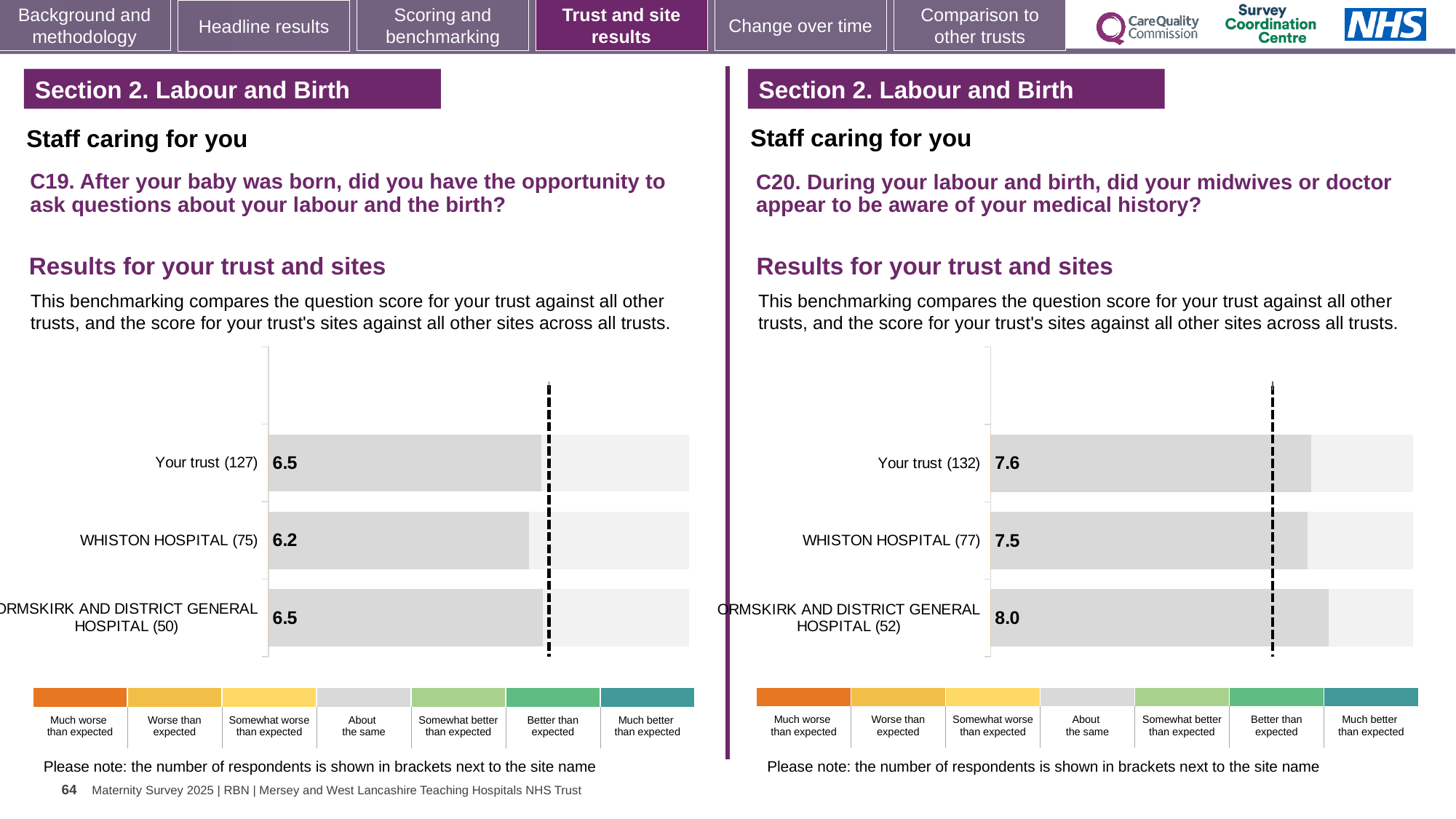
In the C20 chart on the right, what is the score for ORMSKIRK AND DISTRICT GENERAL HOSPITAL? 8.0 In the C20 chart on the right, which has the larger score, Your trust or ORMSKIRK AND DISTRICT GENERAL HOSPITAL? ORMSKIRK AND DISTRICT GENERAL HOSPITAL In the C19 chart on the left, what is the score for WHISTON HOSPITAL? 6.2 In the C19 chart on the left, which site or trust has the lowest score? WHISTON HOSPITAL In the C20 chart on the right, what is the score for Your trust? 7.6 How many bars are shown in the C19 chart on the left? 3 In the C20 chart on the right, which site or trust has the highest score? ORMSKIRK AND DISTRICT GENERAL HOSPITAL In the C20 chart on the right, what is the difference between the scores for ORMSKIRK AND DISTRICT GENERAL HOSPITAL and WHISTON HOSPITAL? 0.5 In the C19 chart on the left, how many respondents are shown in brackets for WHISTON HOSPITAL? 75 What type of chart is used in the C20 chart on the right? Bar chart In the C19 chart on the left, what is the score for Your trust? 6.5 In the C19 chart on the left, what is the difference between the scores for Your trust and WHISTON HOSPITAL? 0.3